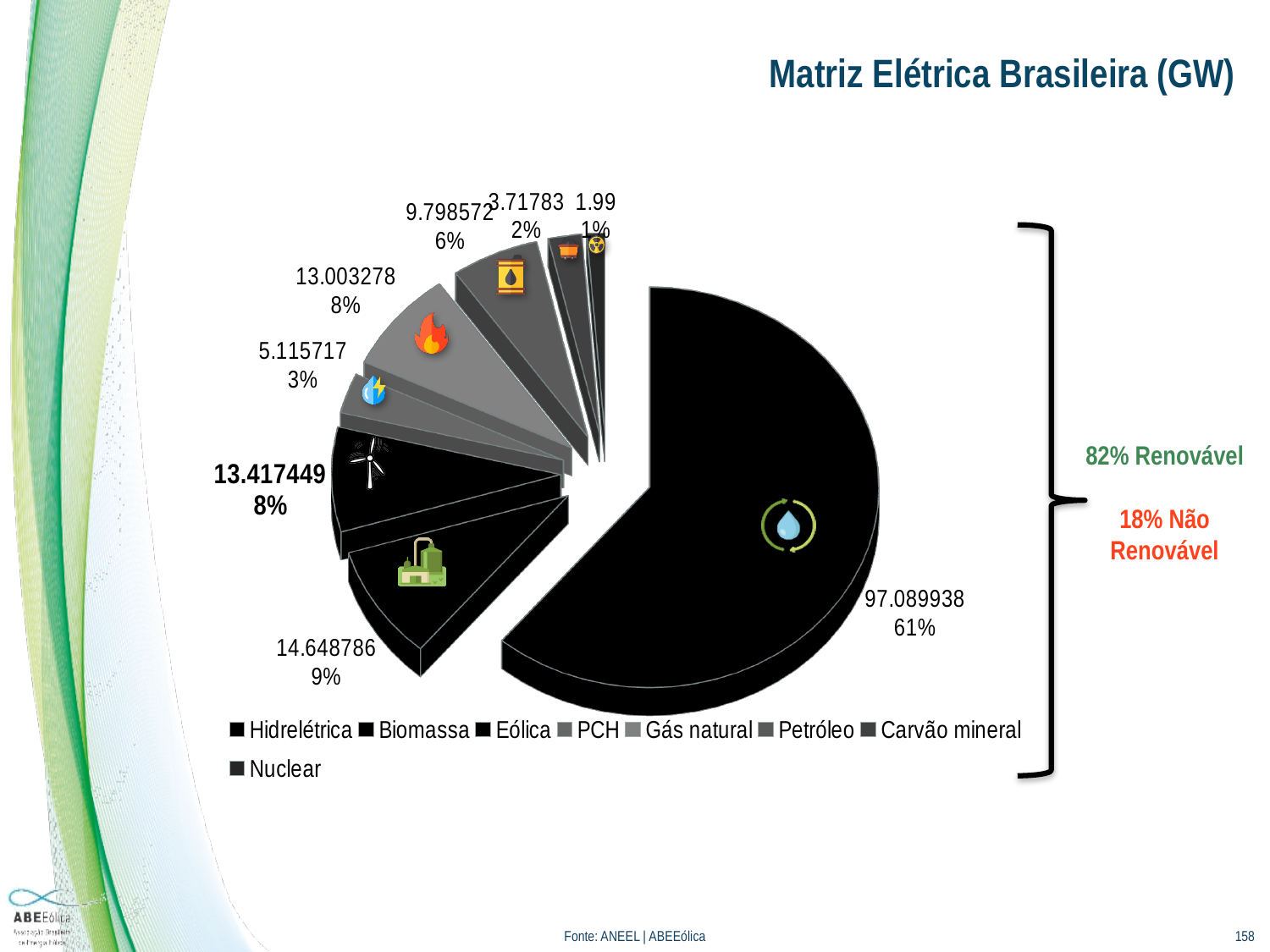
What is the value shown for Eólica? 13.417449 What share of the pie does Petróleo represent? 6% Which category has the smallest slice of the pie? Nuclear What share of the pie does Hidrelétrica represent? 61% Which category has the largest slice of the pie? Hidrelétrica What kind of chart is shown on the slide? Pie chart What is the title of the chart? Matriz Elétrica Brasileira (GW) What is the difference between the share for Hidrelétrica and the share for Biomassa? 52% Which is larger, the value for Biomassa or the value for PCH? Biomassa What is the value shown for Hidrelétrica? 97.089938 What is the value shown for Biomassa? 14.648786 How many series does the legend list? 8